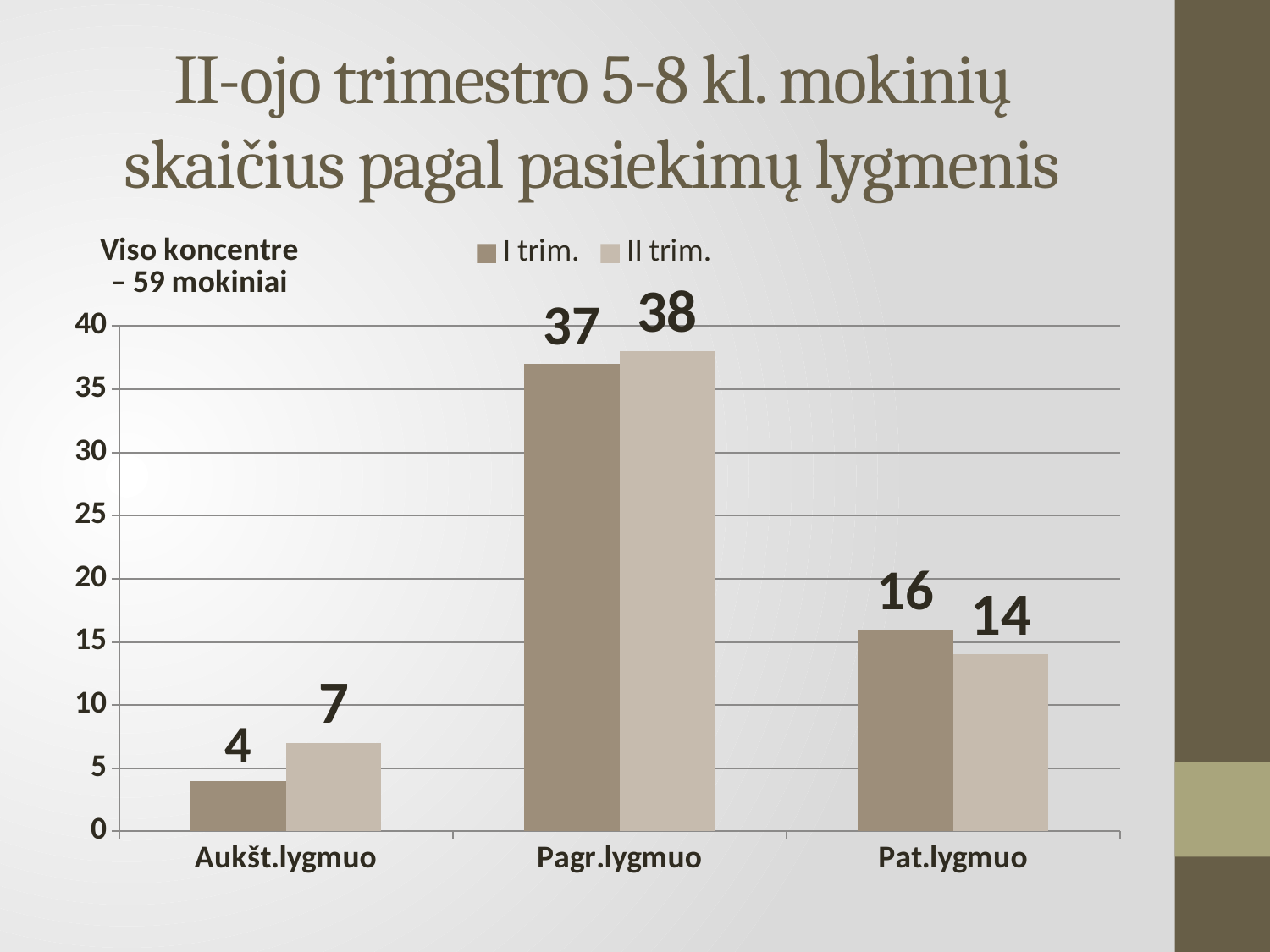
Which is larger for Pat.lygmuo: the I trim. value or the II trim. value? I trim. What is the total number of students stated in the text above the chart? 59 How many series does the legend list? 2 What is the difference between the I trim. and II trim. values for Pat.lygmuo? 2 Which category has the highest value in the II trim. series? Pagr.lygmuo Which category has the lowest value in the I trim. series? Aukšt.lygmuo What is the value for Aukšt.lygmuo in the I trim. series? 4 How many categories are shown on the x axis? 3 What is the difference between the II trim. and I trim. values for Aukšt.lygmuo? 3 What kind of chart is shown on the slide? bar chart What is the value for Pat.lygmuo in the I trim. series? 16 What is the value for Pagr.lygmuo in the II trim. series? 38